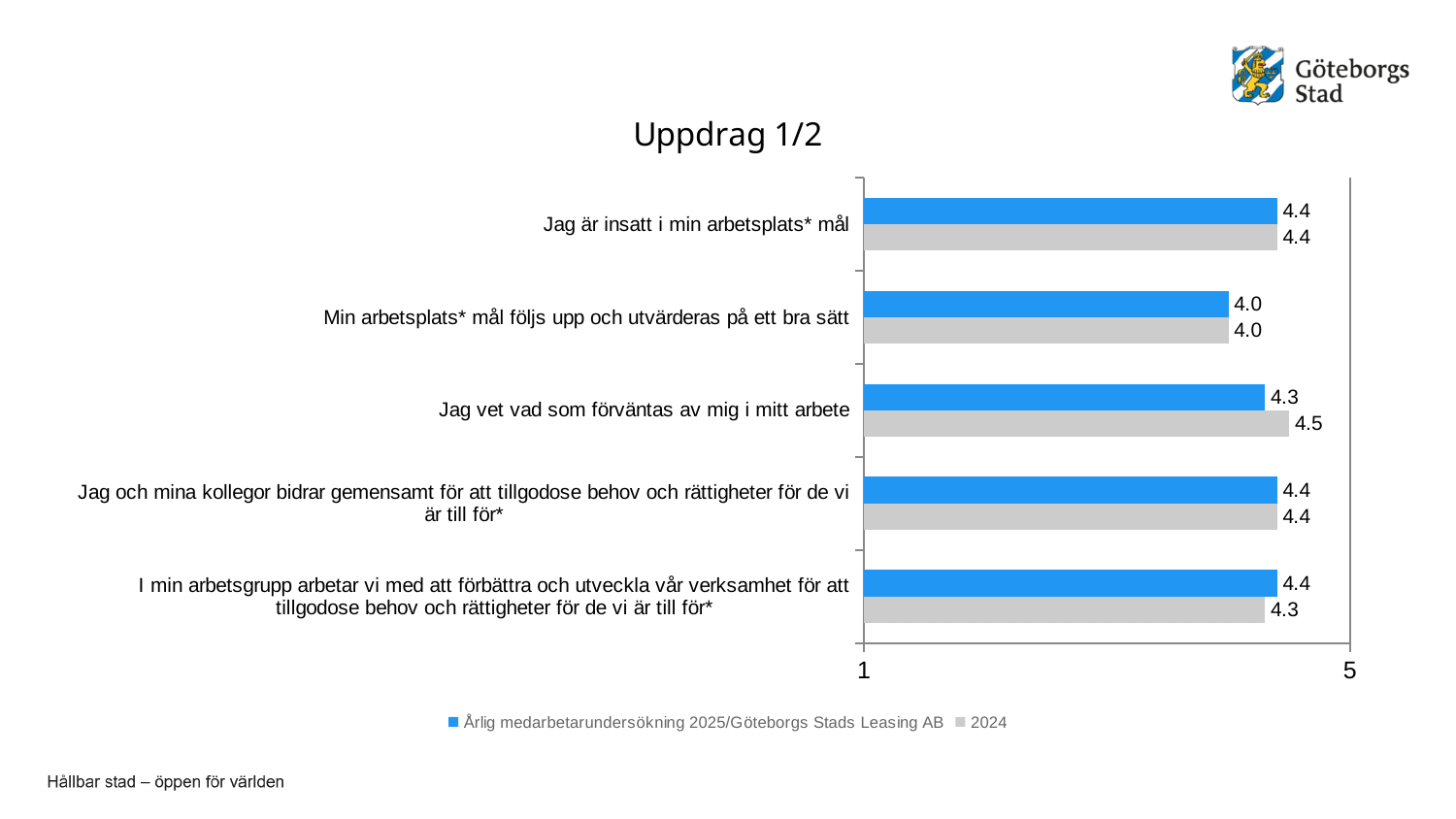
What is the 2024 value for "Jag vet vad som förväntas av mig i mitt arbete"? 4.5 Which category has the lowest value in the 2025 series? Min arbetsplats* mål följs upp och utvärderas på ett bra sätt What is the difference between the 2024 and 2025 values for "Jag vet vad som förväntas av mig i mitt arbete"? 0.2 For "I min arbetsgrupp arbetar vi med att förbättra och utveckla vår verksamhet...", which is larger, the 2025 value or the 2024 value? 2025 How many series does the legend list? 2 What kind of chart is shown on the slide? Bar chart Which category has the highest value in the 2024 series? Jag vet vad som förväntas av mig i mitt arbete What is the 2025 value for "Min arbetsplats* mål följs upp och utvärderas på ett bra sätt"? 4.0 What is the 2024 value for "I min arbetsgrupp arbetar vi med att förbättra och utveckla vår verksamhet för att tillgodose behov och rättigheter för de vi är till för*"? 4.3 How many categories are shown on the chart? 5 What is the title of the chart? Uppdrag 1/2 What is the 2025 value for "Jag är insatt i min arbetsplats* mål"? 4.4